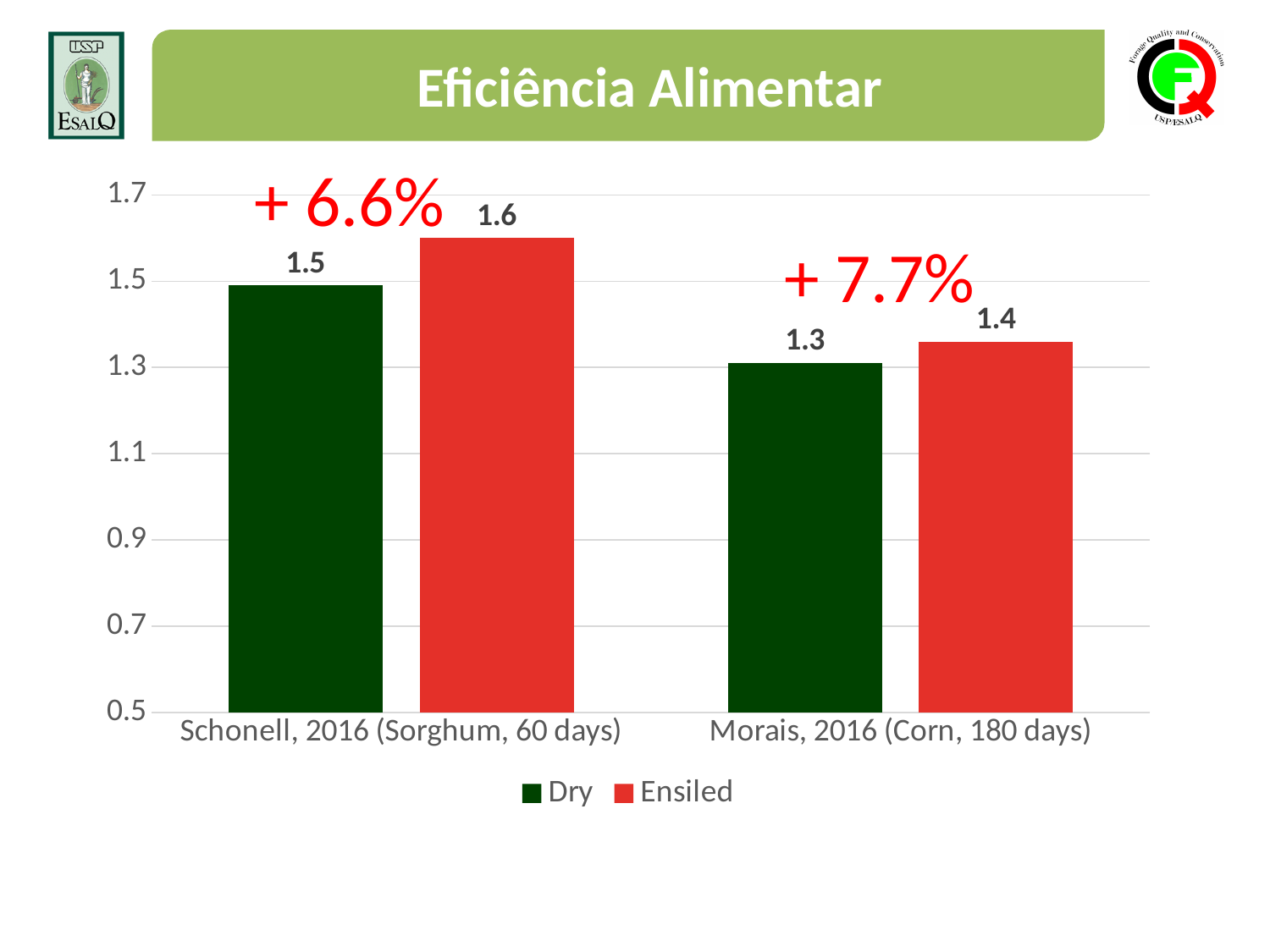
Which category has the lowest Dry value? Morais, 2016 (Corn, 180 days) What is the difference between the Ensiled and Dry values for Morais, 2016 (Corn, 180 days)? 0.1 What is the Dry value for Schonell, 2016 (Sorghum, 60 days)? 1.5 What is the Dry value for Morais, 2016 (Corn, 180 days)? 1.3 Is the Dry value for Morais, 2016 (Corn, 180 days) greater or less than 1.5? less For Schonell, 2016 (Sorghum, 60 days), which is larger: the Dry value or the Ensiled value? Ensiled Which category has the highest Ensiled value? Schonell, 2016 (Sorghum, 60 days) What is the Ensiled value for Schonell, 2016 (Sorghum, 60 days)? 1.6 How many categories are shown on the x axis? 2 What is the Ensiled value for Morais, 2016 (Corn, 180 days)? 1.4 How many series does the legend list? 2 What type of chart is shown on the slide? Bar chart